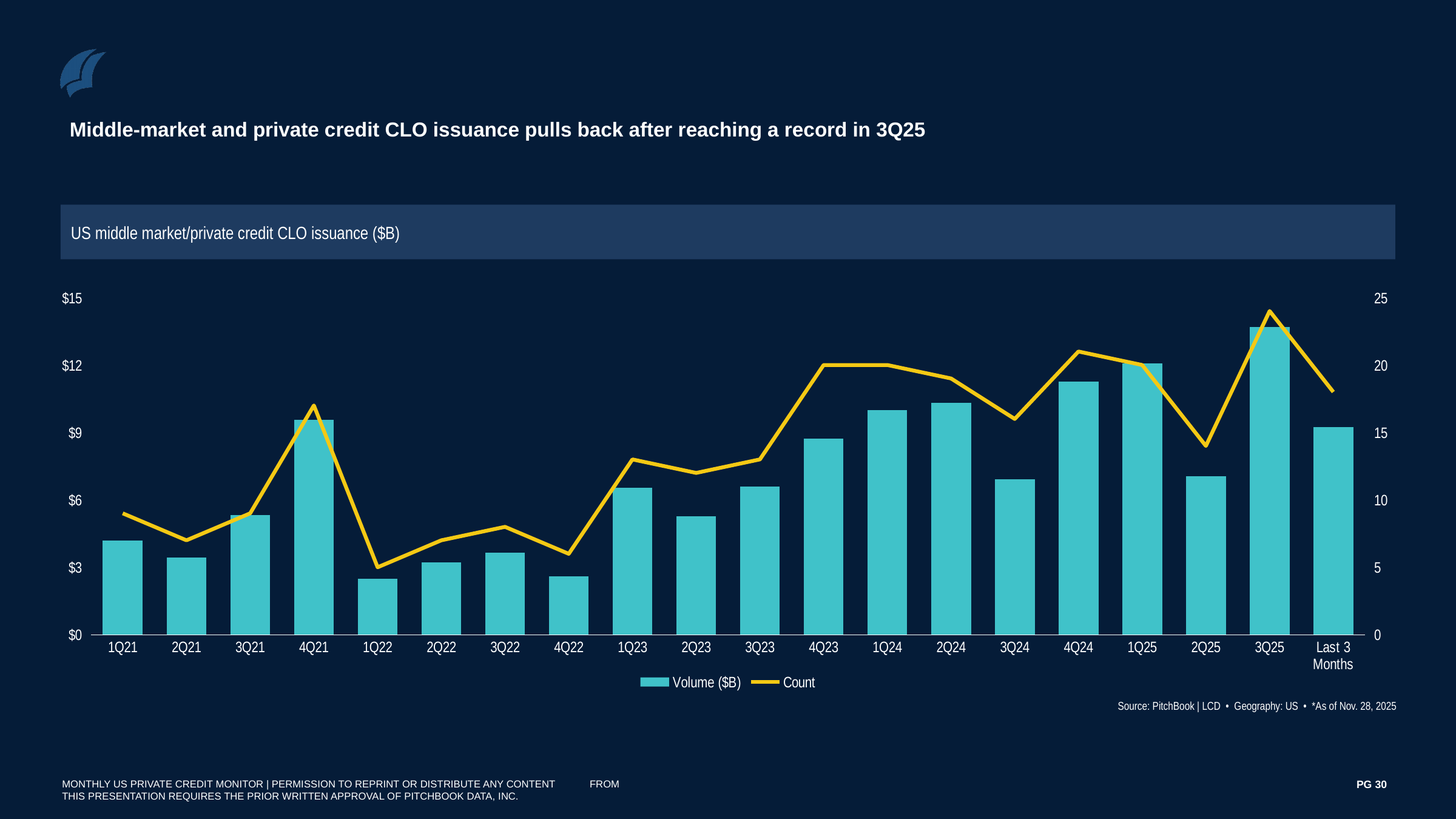
What are the two legend entries on the chart? Volume ($B) and Count In which period does the Count line reach its highest point? 3Q25 How many series does the legend list? 2 What kind of chart is shown on the slide? A bar chart combined with a line Is the Volume ($B) for 1Q22 greater or less than $3? less In which period does the Count line reach its lowest point? 1Q22 How many periods are shown along the x axis? 20 Which period has the highest Volume ($B) bar? 3Q25 Which has the larger Volume ($B), 4Q21 or 1Q22? 4Q21 Does the Volume ($B) rise or fall from 3Q25 to Last 3 Months? fall Is the Volume ($B) for 3Q25 greater or less than $12? greater Is the Count for 3Q25 greater or less than 20? greater